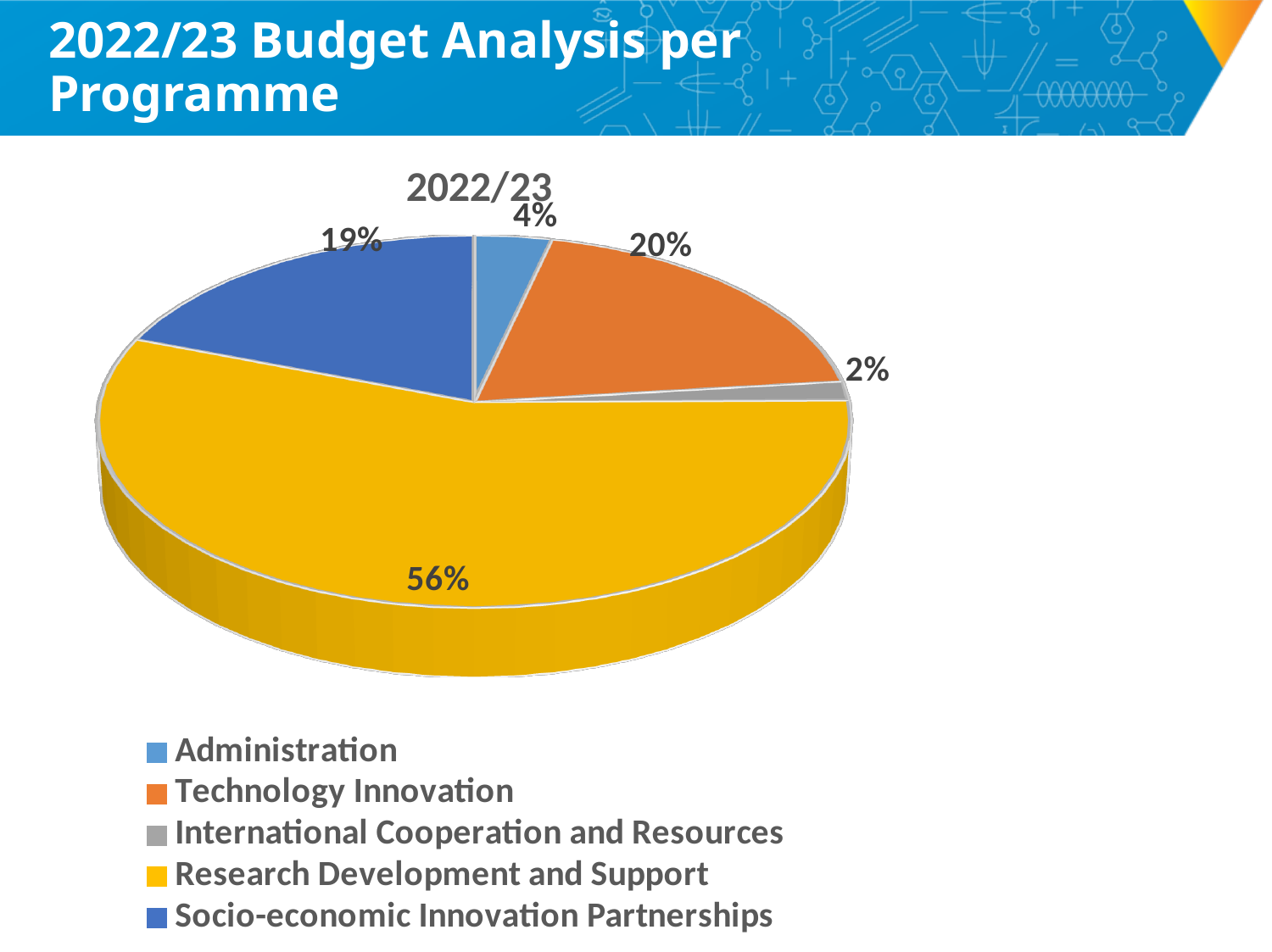
Which has a larger share, Technology Innovation or Socio-economic Innovation Partnerships? Technology Innovation What share of the budget goes to Technology Innovation? 20% What type of chart is shown on the slide? Pie chart How many programmes are listed in the legend? 5 What share of the budget goes to Socio-economic Innovation Partnerships? 19% Which programme has the largest share of the budget? Research Development and Support Which programme has the smallest share of the budget? International Cooperation and Resources What share of the budget goes to Research Development and Support? 56% What is the chart's title? 2022/23 What share of the budget goes to International Cooperation and Resources? 2% What is the difference in percentage points between Research Development and Support and Technology Innovation? 36 What share of the budget goes to Administration? 4%